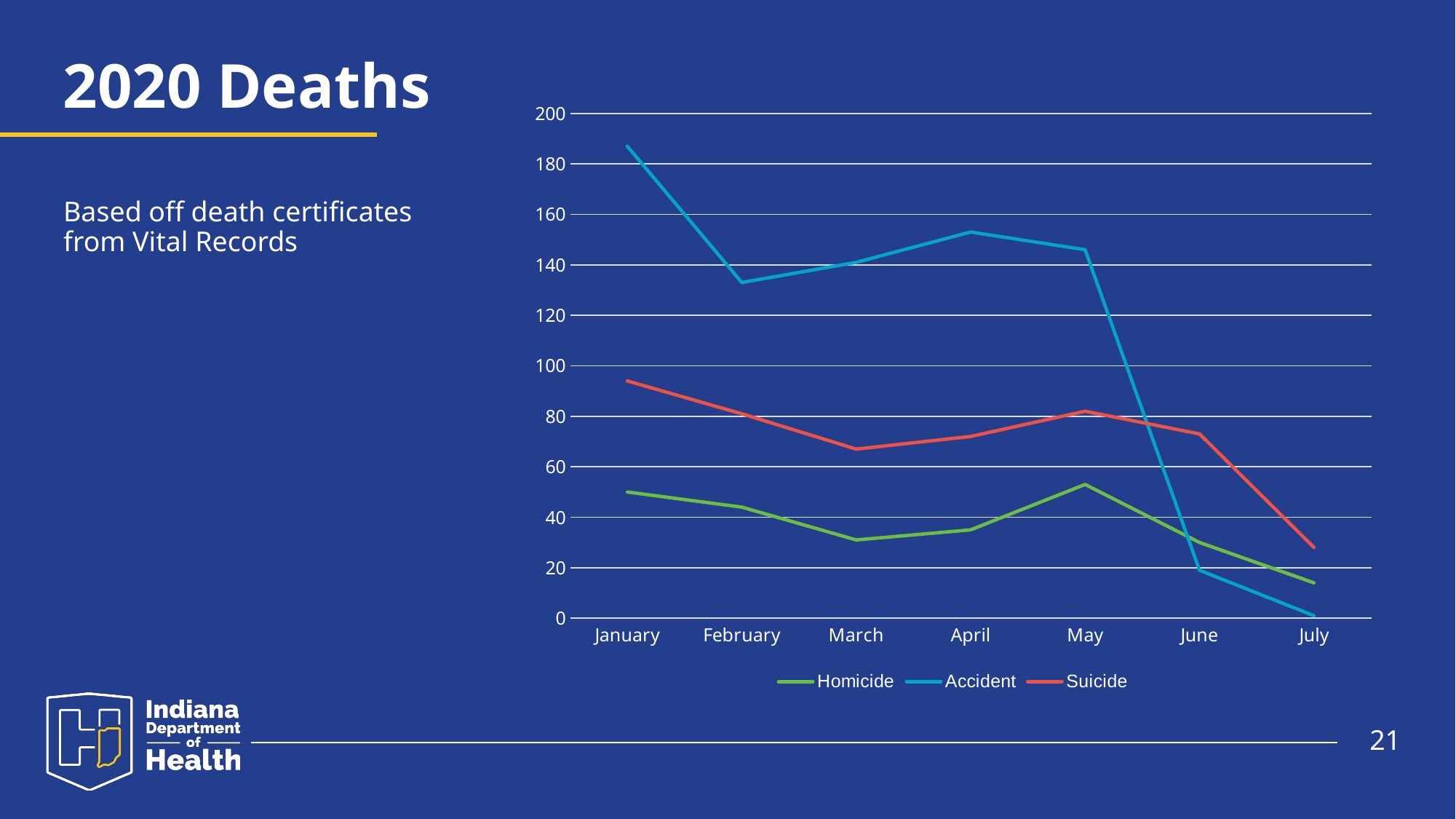
Does the Accident series rise or fall from May to July? fall Is the value for Suicide in March greater or less than 80? less Is the value for Accident in January greater or less than 180? greater What kind of chart is shown on the slide? line chart Which series has the larger value in April, Accident or Suicide? Accident How many series does the legend list? 3 How many months are plotted along the x axis? 7 In which month is the Accident series at its lowest? July In which month is the Accident series at its highest? January Is the value for Accident in June greater or less than 40? less What is the title of the slide containing the chart? 2020 Deaths In which month is the Homicide series at its highest? May